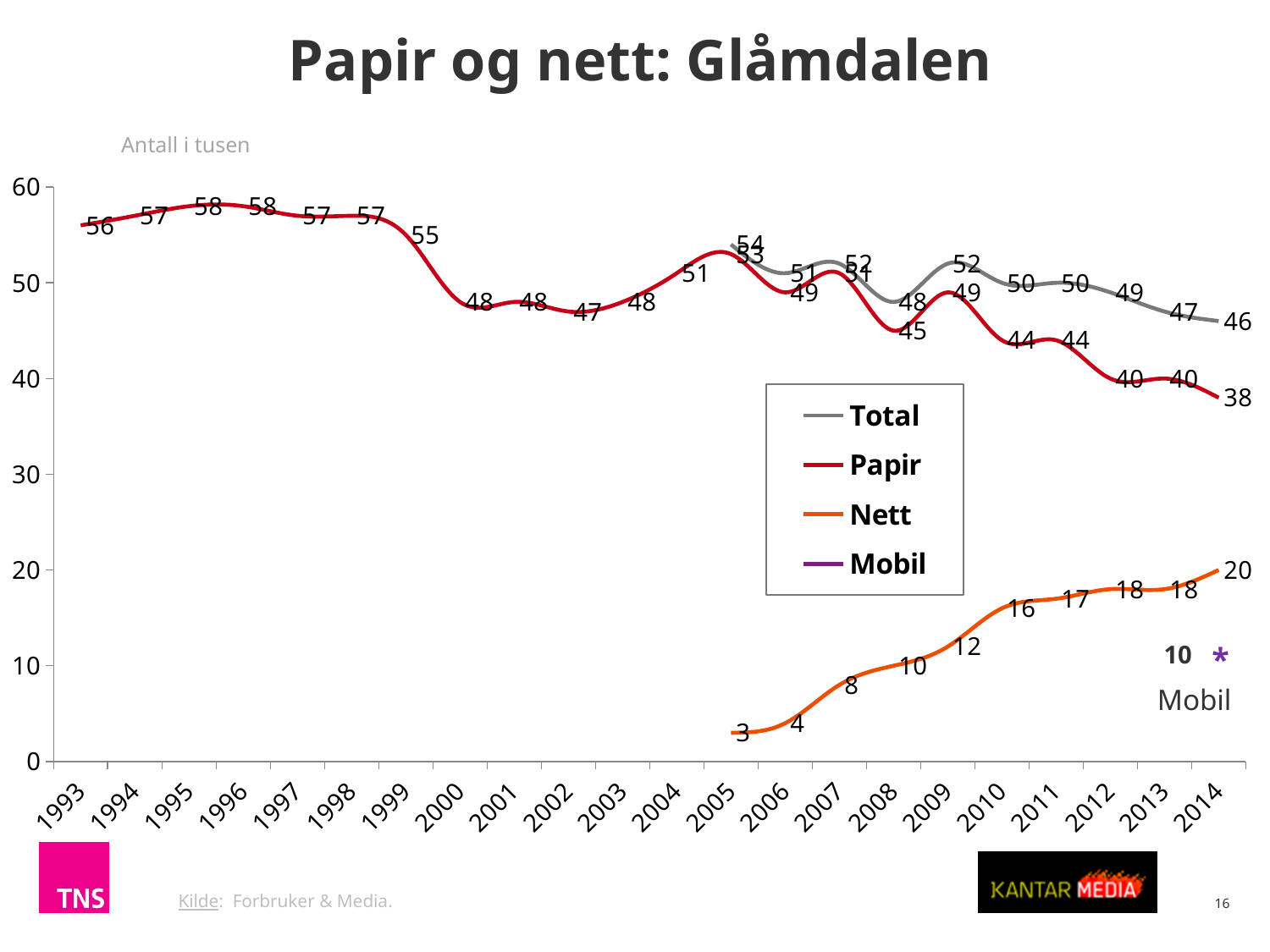
How many series does the legend list? 4 In which year is the Papir value lowest? 2014 What is the value shown for Mobil? 10 How many years are shown on the x axis? 22 What is the value for Papir in 2014? 38 What kind of chart is shown on the slide? Line chart What is the value for Nett in 2005? 3 What is the difference between Total and Papir in 2014? 8 What is the value for Total in 2014? 46 Which is larger in 2008, the Total value or the Papir value? Total What is the value for Nett in 2014? 20 What is the highest value reached by the Papir series? 58